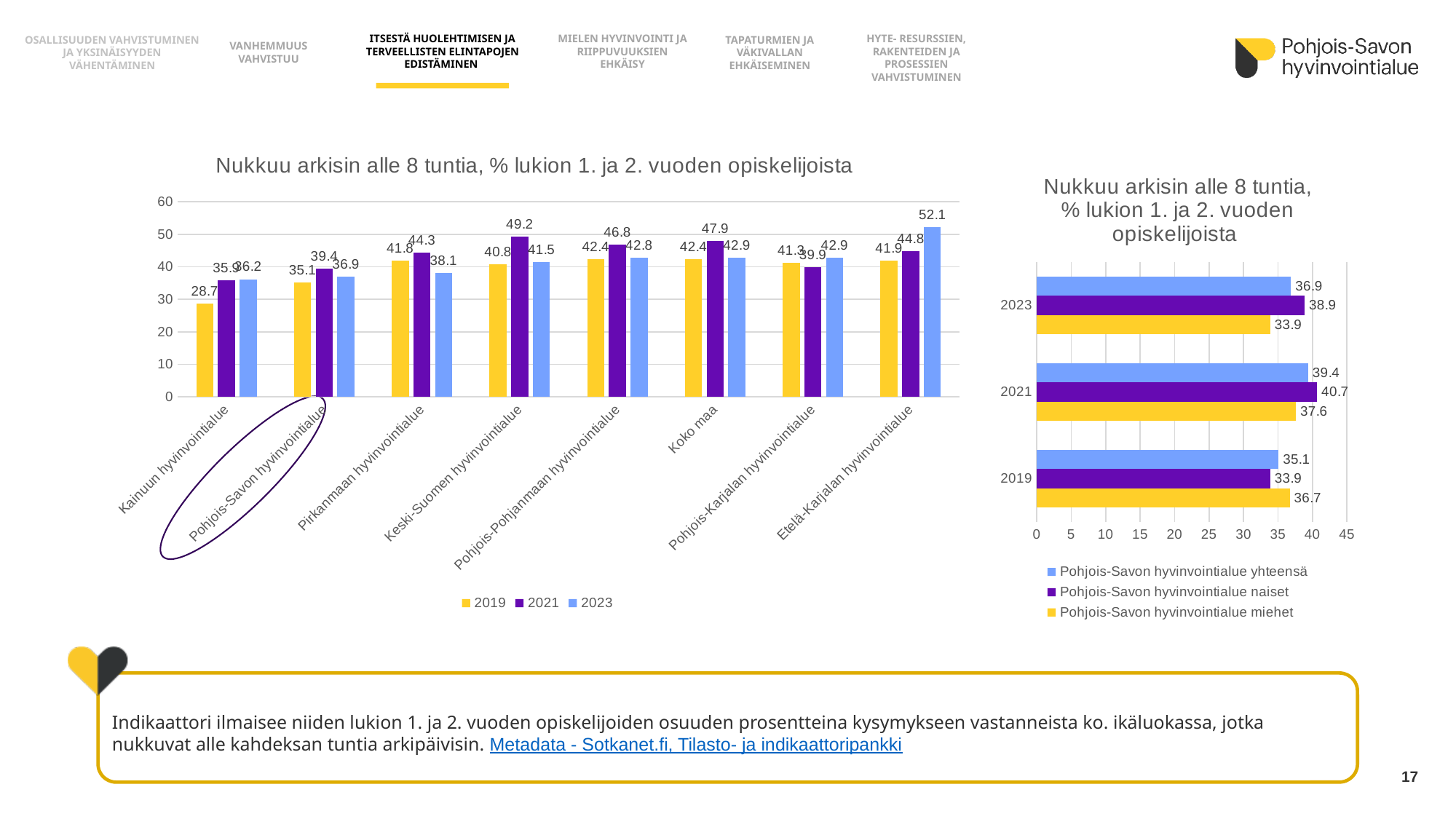
In the left chart, what is the 2019 value for Kainuun hyvinvointialue? 28.7 In the right chart, what is the value for Pohjois-Savon hyvinvointialue naiset in 2023? 38.9 How many regions are shown on the x axis of the left chart? 8 How many series does the legend of the left chart list? 3 In the left chart, which region has the lowest 2019 value? Kainuun hyvinvointialue In the left chart, which is larger for Pohjois-Karjalan hyvinvointialue: the 2019 value or the 2021 value? 2019 What kind of chart is the chart on the right? Bar chart In the left chart, which region has the highest 2023 value? Etelä-Karjalan hyvinvointialue In the right chart, which year has the highest value for Pohjois-Savon hyvinvointialue miehet? 2021 In the left chart, what is the difference between the 2021 and 2019 values for Pohjois-Savon hyvinvointialue? 4.3 In the right chart, what is the difference between the naiset and miehet values in 2021? 3.1 In the left chart, what is the 2021 value for Keski-Suomen hyvinvointialue? 49.2